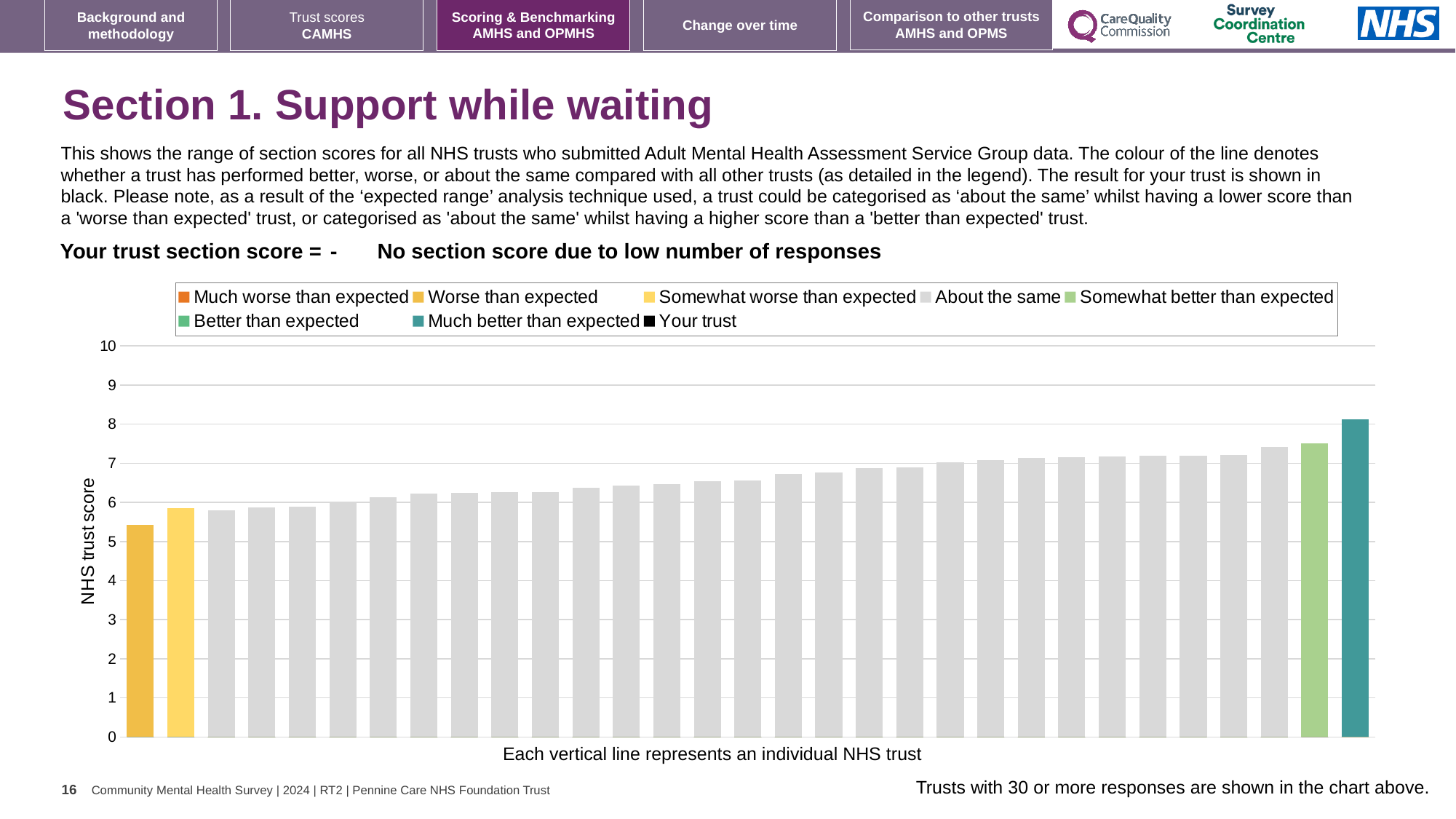
What kind of chart is shown on the slide? Bar chart Is the value of the shortest bar in the chart greater or less than 6? less Which legend category does the tallest bar in the chart belong to? Much better than expected What is the label on the vertical axis of the chart? NHS trust score What is the trust's section score for Support while waiting shown on the slide? No section score due to low number of responses Is the value of the shortest bar in the chart greater or less than 5? greater How many entries does the chart legend list? 8 What does each vertical line in the chart represent, according to the x-axis label? An individual NHS trust Is the value of the tallest bar in the chart greater or less than 7? greater Which legend category does the shortest bar in the chart belong to? Worse than expected What is the highest value shown on the vertical axis of the chart? 10 Do the bar values rise or fall from left to right across the chart? Rise